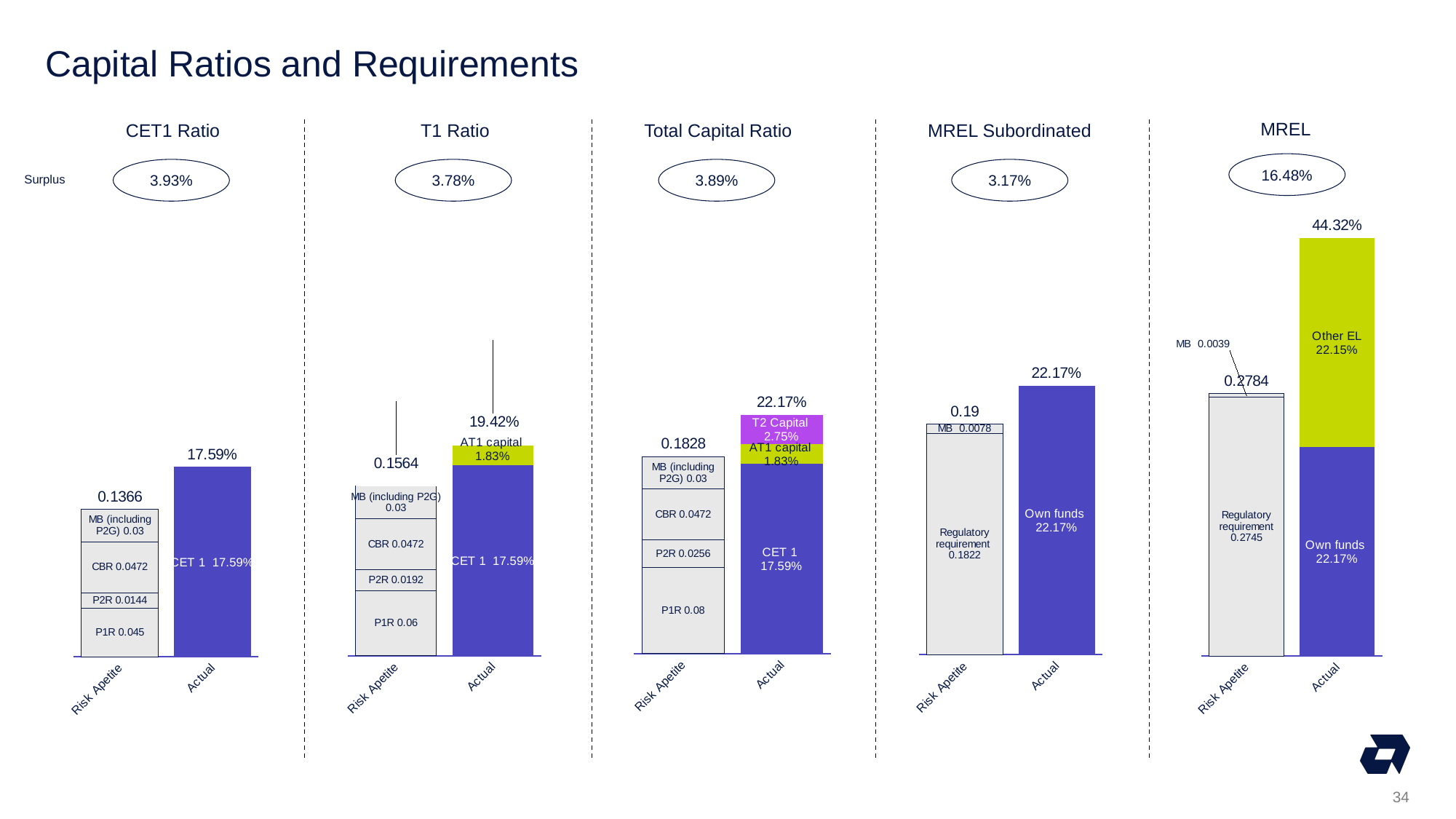
What kind of chart is the CET1 Ratio chart? Bar chart In the MREL chart, what is the value of the Other EL segment? 22.15% In the T1 Ratio chart, what is the value of the AT1 capital segment? 1.83% In the CET1 Ratio chart, what is the value labelled on the Actual bar? 17.59% In the MREL Subordinated chart, what is the total of the Risk Apetite stacked bar? 0.19 In the MREL Subordinated chart, what is the value of the Regulatory requirement segment? 0.1822 In the Total Capital Ratio chart, what is the value of the T2 Capital segment? 2.75% In the Total Capital Ratio chart, which bar is taller, Risk Apetite or Actual? Actual In the CET1 Ratio chart, what is the total value labelled above the Risk Apetite bar? 0.1366 In the T1 Ratio chart, what is the value of the P1R segment? 0.06 How many bars are shown in the T1 Ratio chart? 2 In the MREL chart, what is the total value labelled above the Actual bar? 44.32%